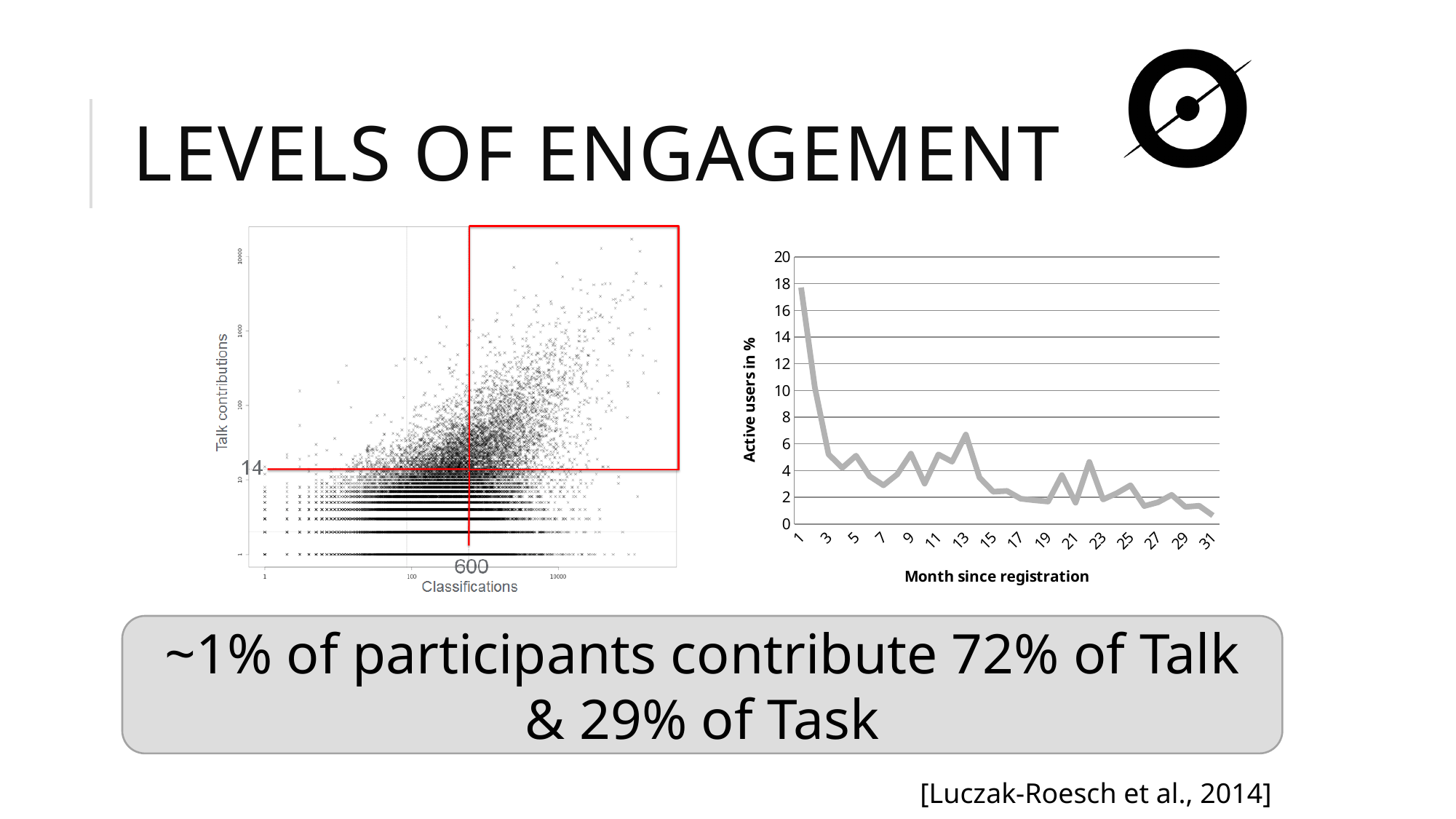
What is the label of the y axis of the right chart? Active users in % What kind of chart is the chart on the right of the slide? line chart In the right chart, is the value for month 13 greater or less than 6? greater In the left chart, at what number of classifications is the red vertical line drawn? 600 In the right chart, which has a higher percentage of active users, month 1 or month 13? month 1 In the right chart, do the values generally rise or fall as the month since registration increases? fall In the right chart, is the value for month 31 greater or less than 2? less What kind of chart is the chart on the left of the slide? scatter plot In the right chart, which month since registration has the lowest percentage of active users? 31 In the right chart, is the value for month 1 greater or less than 16? greater In the right chart, which month since registration has the highest percentage of active users? 1